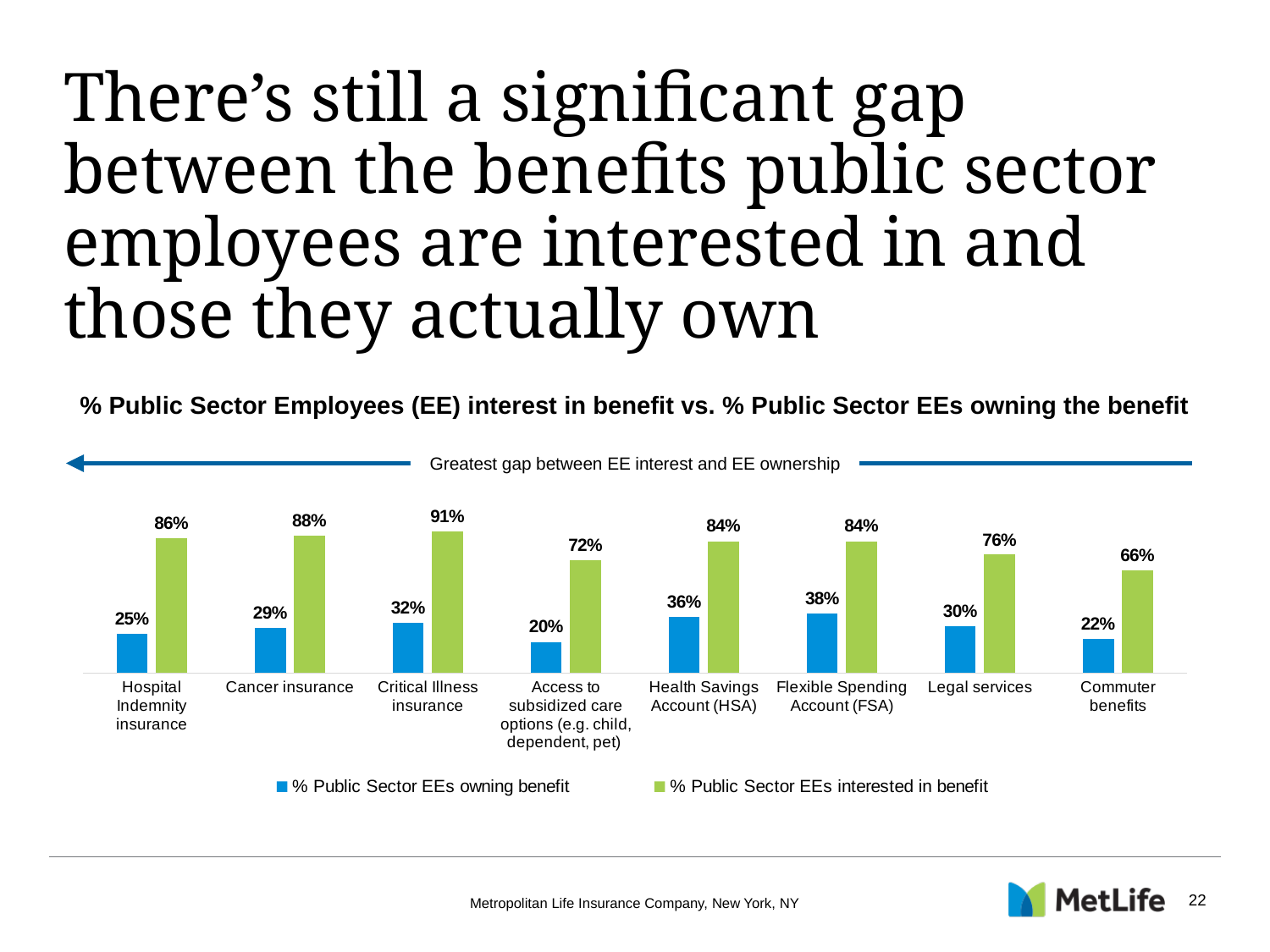
Which category has the lowest value for '% Public Sector EEs owning benefit'? Access to subsidized care options (e.g. child, dependent, pet) What percentage of public sector employees are interested in Critical Illness insurance? 91% What percentage of public sector employees own Hospital Indemnity insurance? 25% What is the title of the chart? % Public Sector Employees (EE) interest in benefit vs. % Public Sector EEs owning the benefit How many benefit categories are shown on the x axis? 8 How many series does the legend list? 2 Which is larger: the percentage of public sector employees owning a Flexible Spending Account (FSA) or owning a Health Savings Account (HSA)? Flexible Spending Account (FSA) Which colour represents the '% Public Sector EEs interested in benefit' series? Green What is the value for Commuter benefits in the '% Public Sector EEs interested in benefit' series? 66% What is the difference between the interest and ownership percentages for Cancer insurance? 59% What kind of chart is shown on the slide? Bar chart Which category has the highest value for '% Public Sector EEs interested in benefit'? Critical Illness insurance